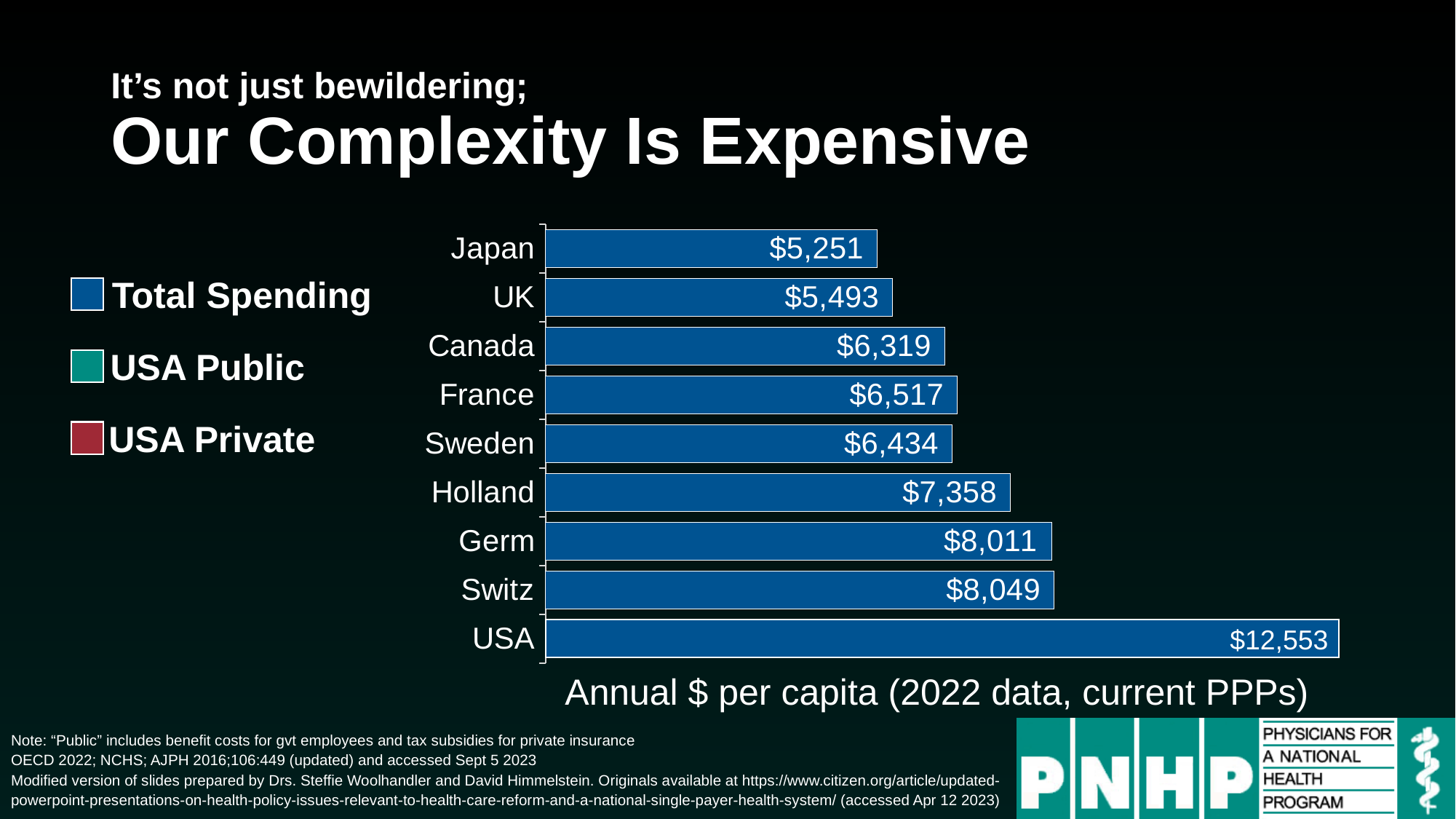
Which country has the lowest annual per capita spending in the chart? Japan Which country has the highest annual per capita spending in the chart? USA What kind of chart is shown on the slide? Bar chart What is the difference between the Canada value and the UK value? $826 How many countries are shown in the chart? 9 How many entries does the legend list? 3 What is the difference between the USA value and the Switz value? $4,504 What is the value shown for Holland? $7,358 Which has the larger value, France or Sweden? France What is the annual per capita spending value shown for Canada? $6,319 What is the value shown for the USA bar? $12,553 Which has the larger value, Switz or Germ? Switz